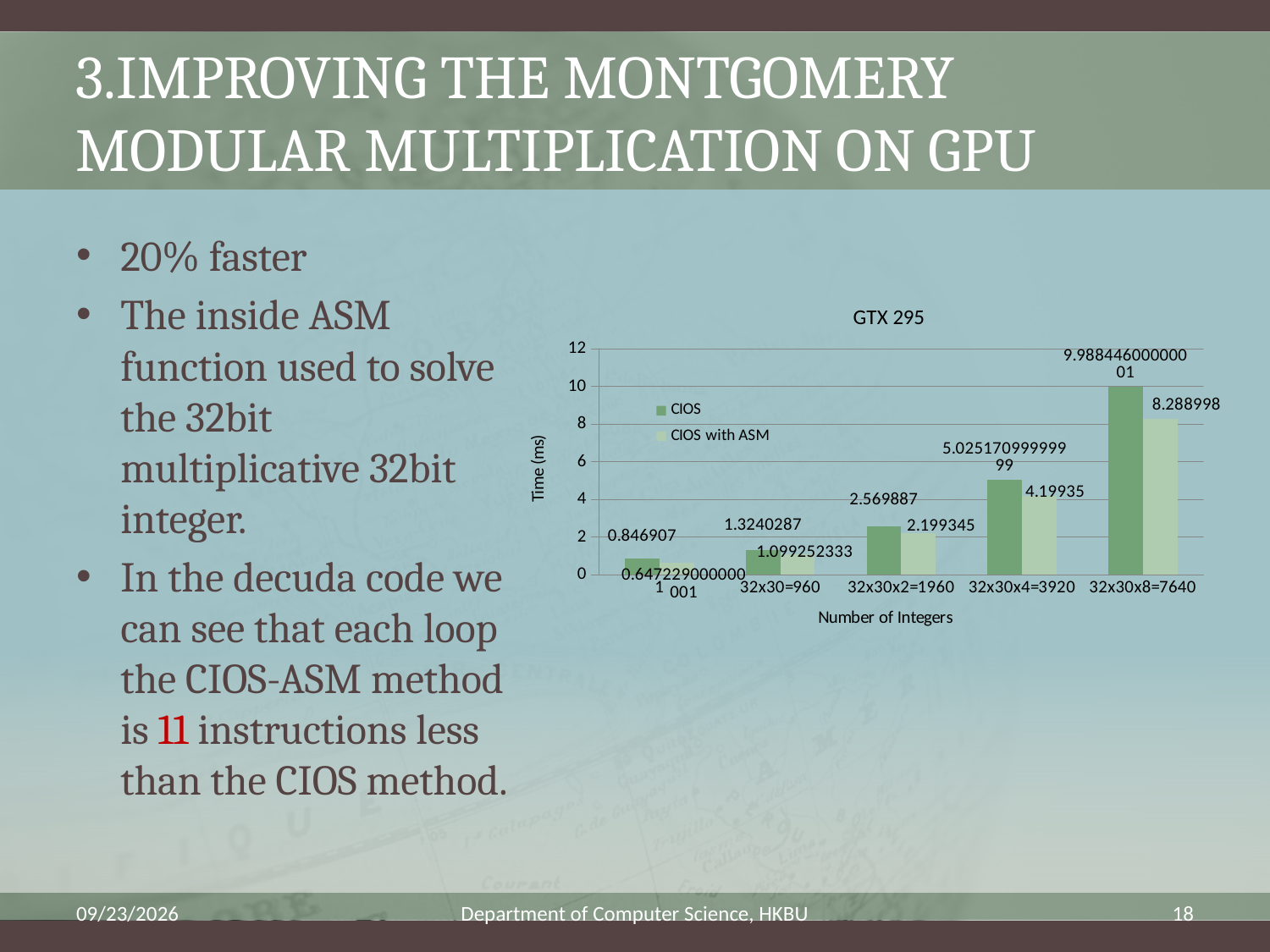
What is the difference between the CIOS and CIOS with ASM values for 32x30x2=1960? 0.370542 What is the CIOS with ASM value for 32x30=960? 1.099252333 What is the CIOS value for 32x30=960? 1.3240287 What is the CIOS with ASM value for 32x30x4=3920? 4.19935 Do the CIOS values rise or fall from left to right along the x axis? rise What is the CIOS with ASM value for 32x30x8=7640? 8.288998 What is the title of the chart? GTX 295 What is the CIOS value for 32x30x2=1960? 2.569887 How many series does the chart legend list? 2 Which category has the highest CIOS value? 32x30x8=7640 How many categories are shown on the x axis of the chart? 5 What type of chart is shown on the slide? bar chart